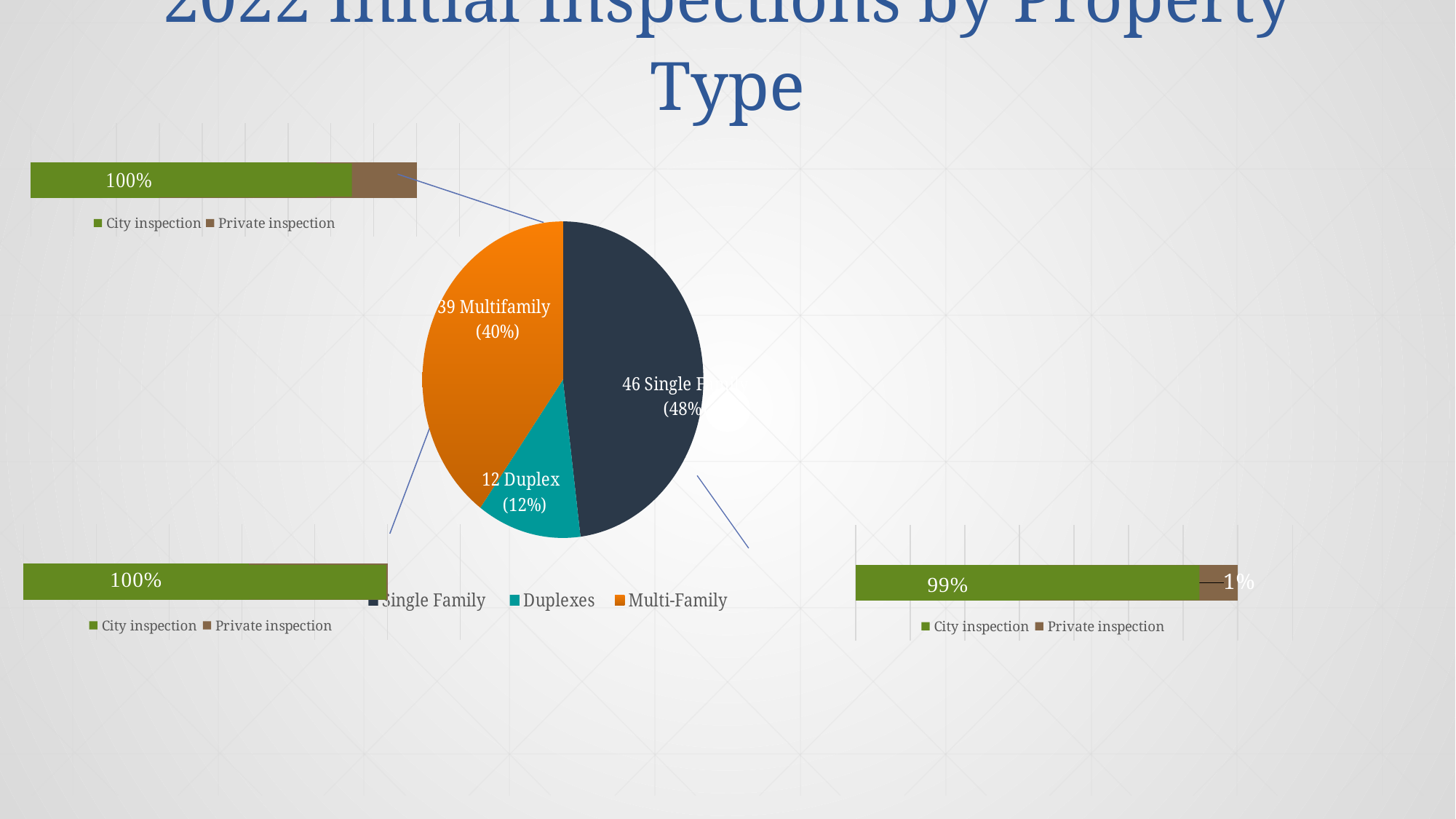
In the central pie chart, how many single family inspections are shown? 46 How many series does the legend of the bottom-right bar chart list? 2 In the central pie chart, what is the difference between the number of Single Family and Multifamily inspections? 7 In the central pie chart, what share of the pie is Multifamily? 40% In the central pie chart, which is larger, the Multifamily slice or the Duplex slice? Multifamily In the central pie chart, what share of the pie is Duplex? 12% In the central pie chart, which property type has the smallest slice? Duplex In the bar chart at the bottom right of the slide, what percentage is labelled for City inspection? 99% In the central pie chart, how many multifamily inspections are shown? 39 In the central pie chart, which property type has the largest slice? Single Family What kind of chart is the central chart on the slide? pie chart In the central pie chart, how many slices are there? 3